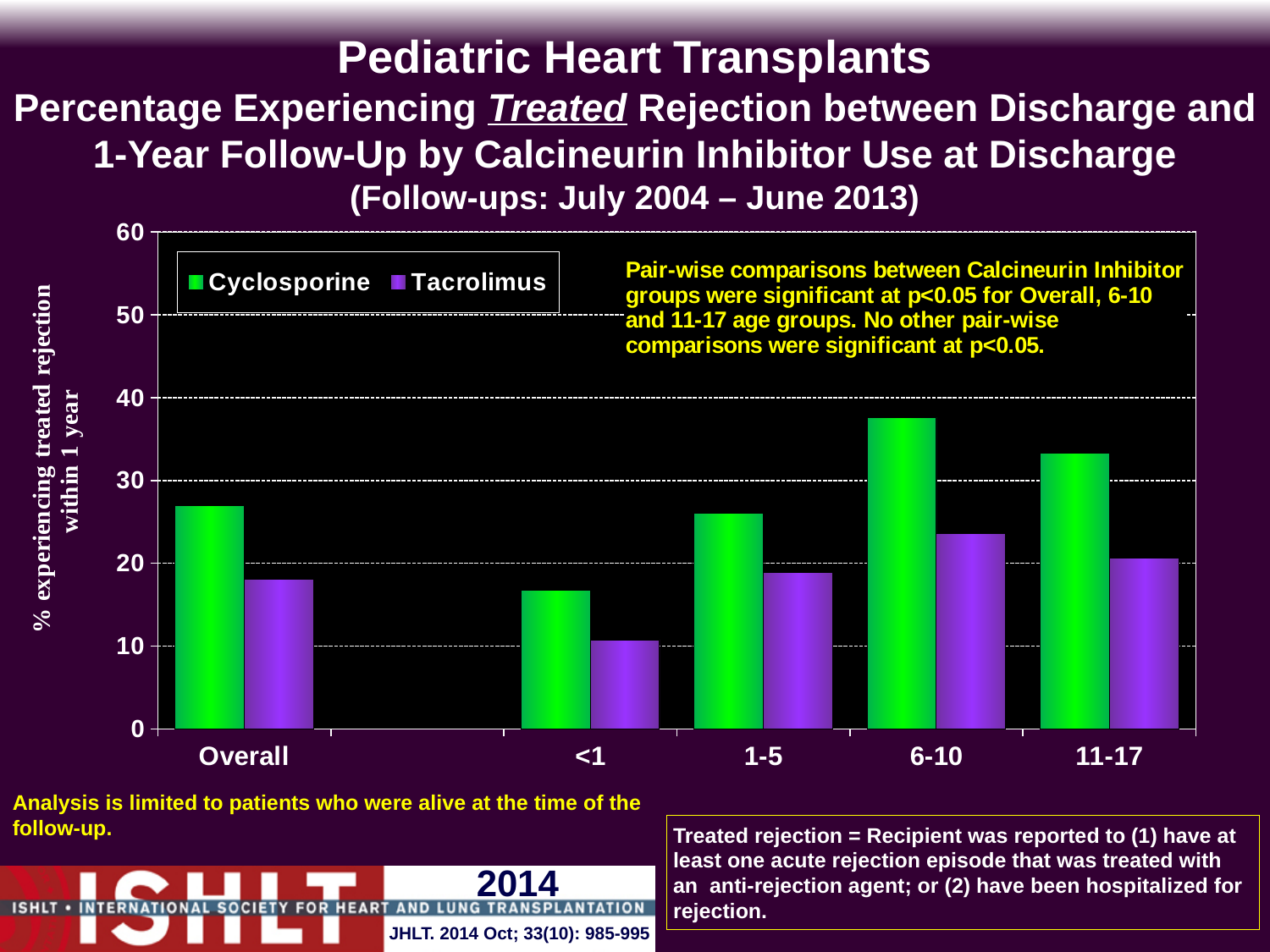
Is the Cyclosporine value for the <1 age group greater or less than 20? less How many age-group categories are shown on the x axis? 5 Is the Cyclosporine value for the 6-10 age group greater or less than 30? greater Which category has the highest Cyclosporine bar? 6-10 Which category has the lowest Tacrolimus bar? <1 What kind of chart is shown on the slide? bar chart Which colour represents Tacrolimus in the legend? purple For the Overall category, which is larger: the Cyclosporine value or the Tacrolimus value? Cyclosporine How many series does the legend list? 2 Which category has the highest Tacrolimus bar? 6-10 Is the Tacrolimus value for the <1 age group greater or less than 20? less Which category has the lowest Cyclosporine bar? <1